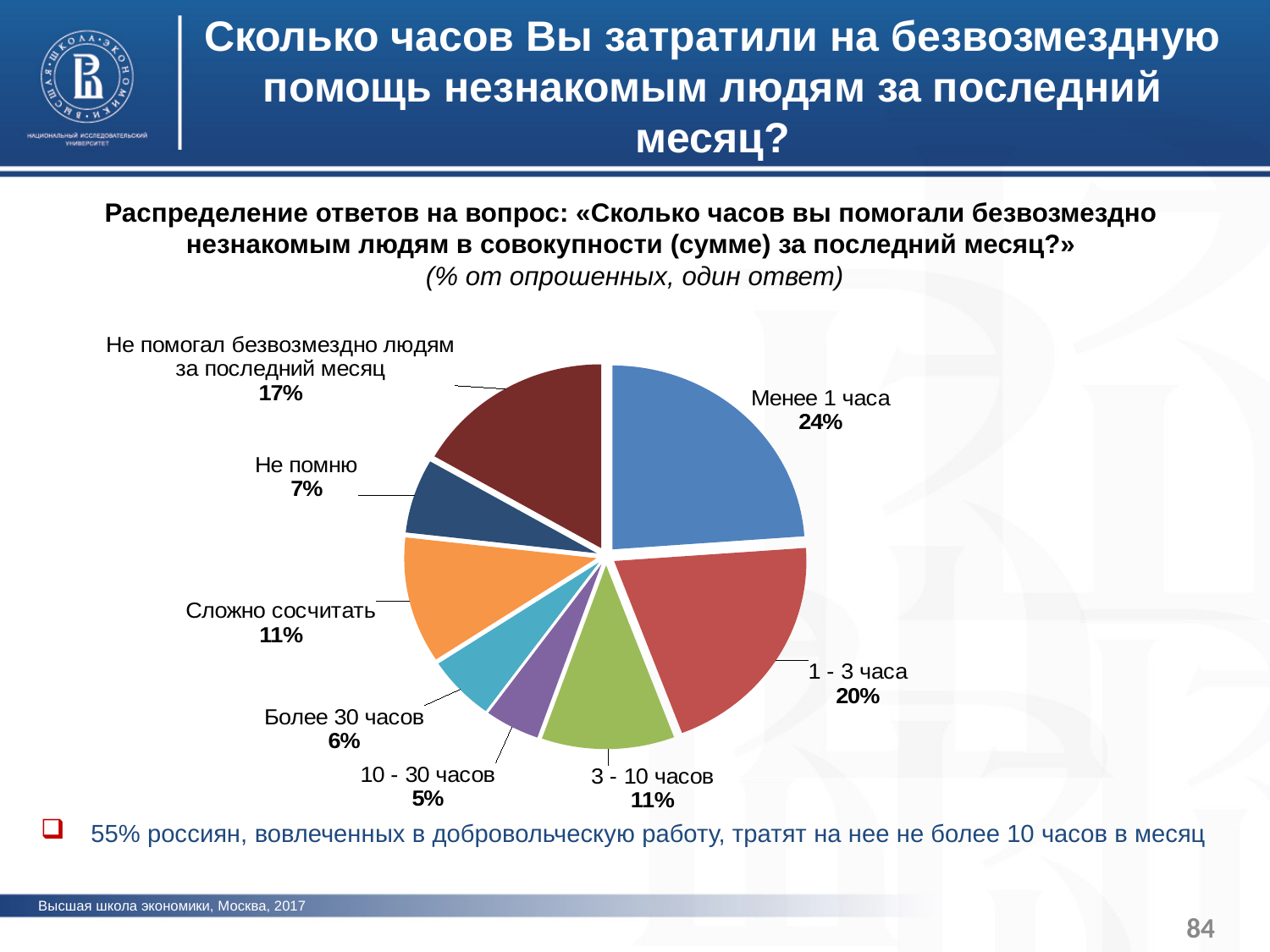
What colour is the slice for «Сложно сосчитать»? orange What percentage of respondents answered «Не помогал безвозмездно людям за последний месяц»? 17% What percentage of respondents answered «Менее 1 часа»? 24% What is the combined share of «Сложно сосчитать» and «Не помню»? 18% Which answer category has the largest share of the pie? Менее 1 часа What is the difference in percentage points between «Менее 1 часа» and «1 - 3 часа»? 4 What type of chart is shown on the slide? pie chart Which is larger: the share for «Не помню» or the share for «Более 30 часов»? Не помню What percentage of respondents answered «10 - 30 часов»? 5% How many answer categories (slices) does the pie chart have? 8 What percentage of respondents answered «1 - 3 часа»? 20% Which answer category has the smallest share of the pie? 10 - 30 часов